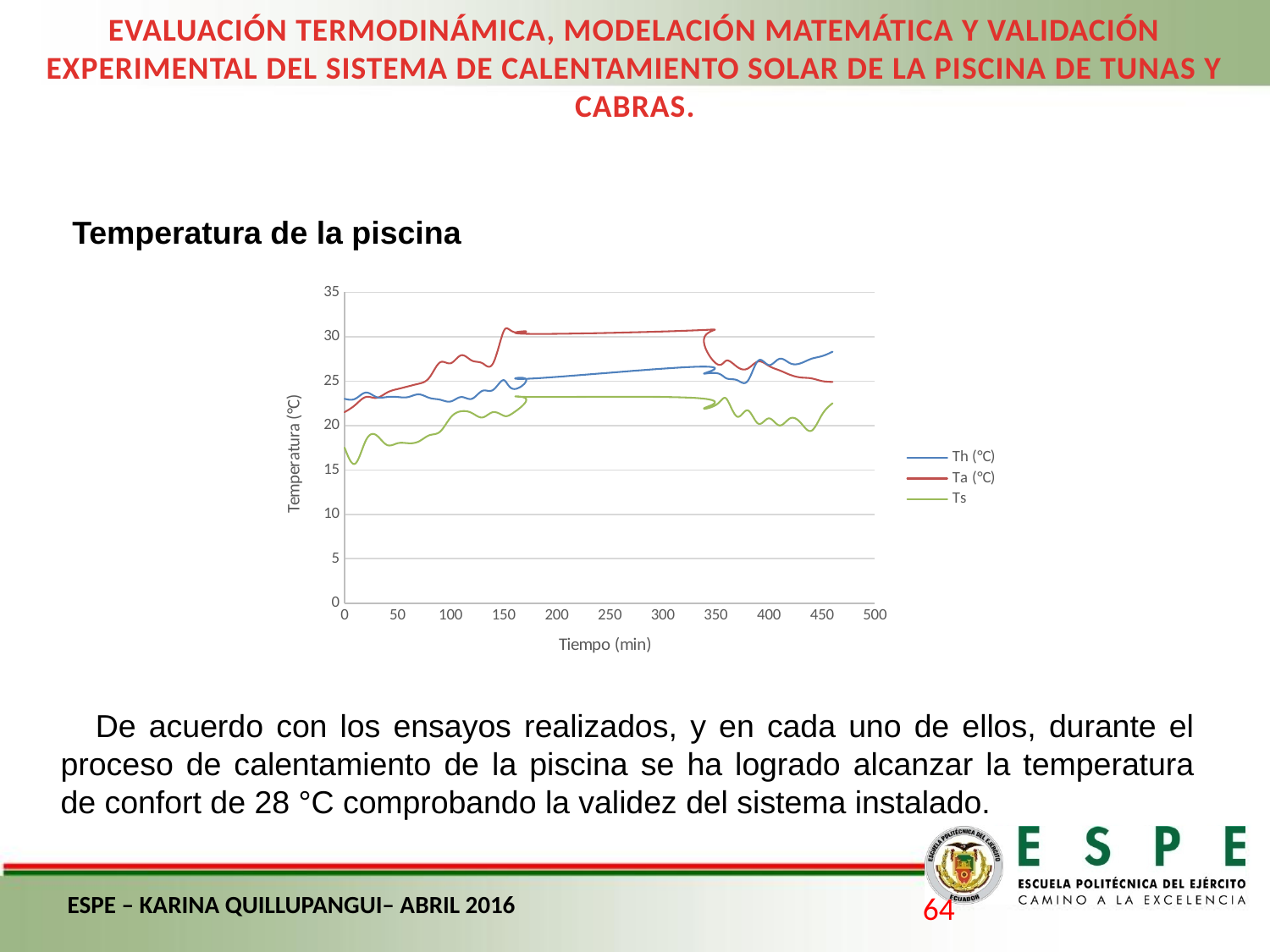
Is the value of Ta (°C) at 250 min greater or less than 25? greater At 250 min, which series is higher, Ta (°C) or Ts? Ta (°C) How many series does the legend of the chart list? 3 Does the Th (°C) series rise or fall overall from 0 min to its last point near 460 min? rise What is the title of the x axis of the chart? Tiempo (min) Is the value of Ts at 250 min greater or less than 25? less Is the value of Ts at 10 min greater or less than 20? less What kind of chart is shown on the slide? Line chart Which series reaches the highest temperature in the chart? Ta (°C) Which series has the lowest temperature value in the chart? Ts What are the three series named in the chart legend? Th (°C), Ta (°C), Ts At 250 min, which series is higher, Th (°C) or Ta (°C)? Ta (°C)